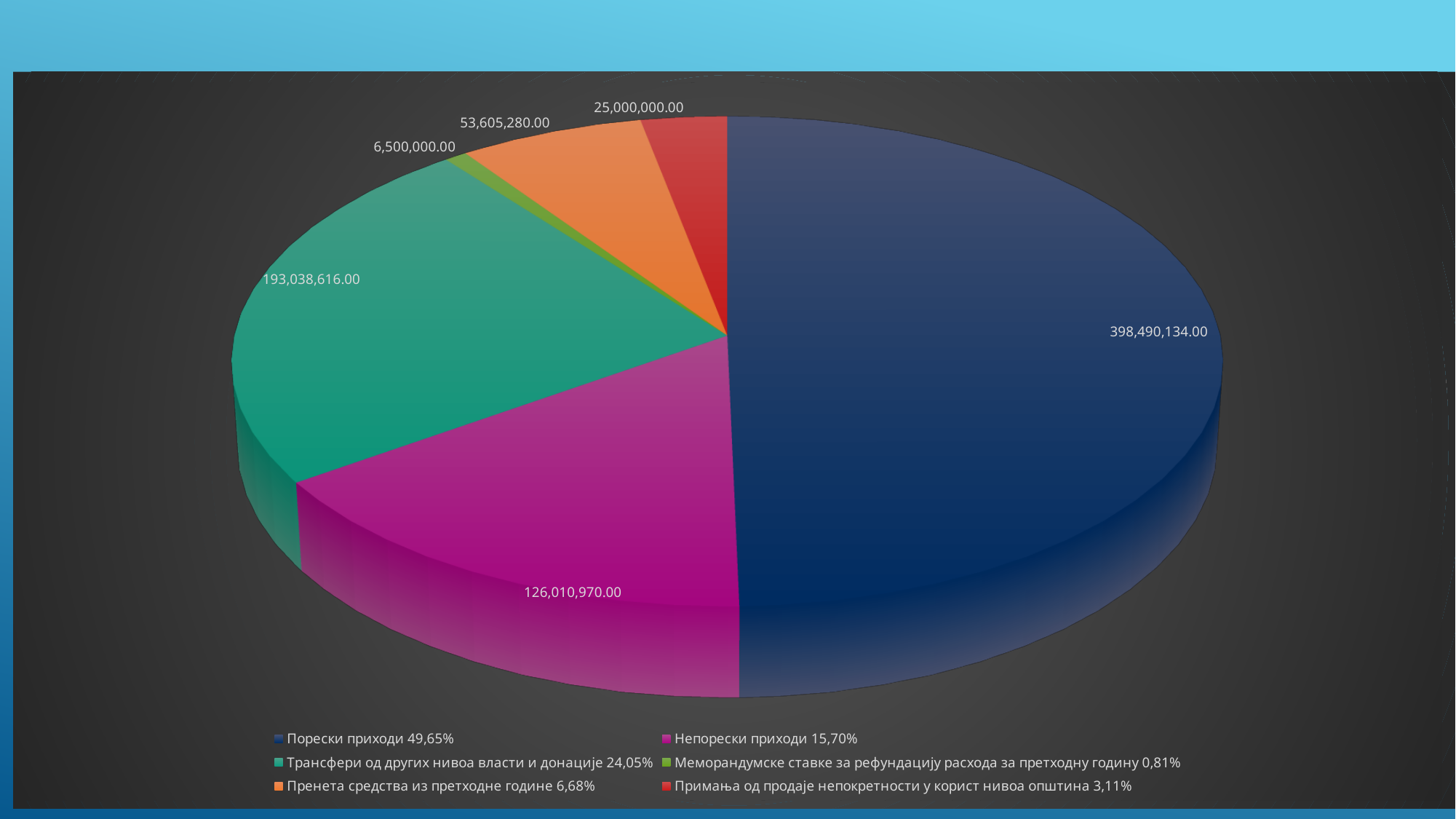
What is the value of the Непорески приходи slice? 126,010,970.00 Which is larger: Пренета средства из претходне године or Примања од продаје непокретности у корист нивоа општина? Пренета средства из претходне године What type of chart is shown on the slide? Pie chart What share of the pie does Трансфери од других нивоа власти и донације represent? 24,05% What is the difference between the Порески приходи value and the Непорески приходи value? 272,479,164.00 Which category has the smallest slice of the pie? Меморандумске ставке за рефундацију расхода за претходну годину What is the value of the Трансфери од других нивоа власти и донације slice? 193,038,616.00 Which category has the largest slice of the pie? Порески приходи What colour is the Непорески приходи slice? Magenta How many slices does the pie chart have? 6 What is the value of the Порески приходи slice? 398,490,134.00 What is the value of the Пренета средства из претходне године slice? 53,605,280.00